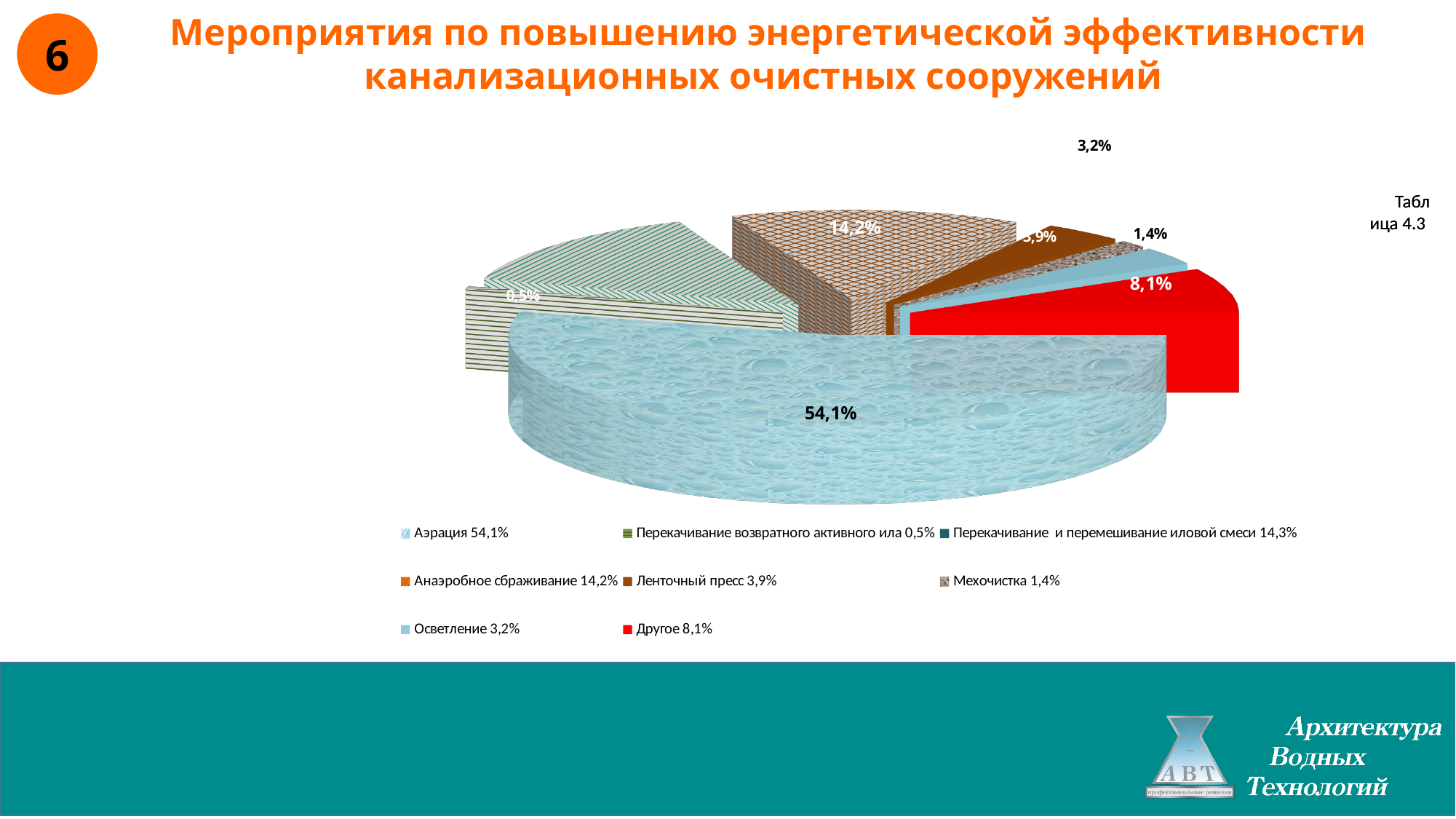
Which category has the largest share of the pie? Аэрация What is the value for Осветление? 3,2% What kind of chart is shown on the slide? pie chart What colour is the slice for Другое? red What is the difference between the shares of Ленточный пресс and Мехочистка? 2,5% What is the difference between the shares of Аэрация and Другое? 46,0% What is the value for Ленточный пресс? 3,9% Which category has the smallest share of the pie? Перекачивание возвратного активного ила How many categories does the pie chart have? 8 What is the value for Другое? 8,1% What share of the pie does Аэрация account for? 54,1% Which is larger, the share for Мехочистка or the share for Осветление? Осветление